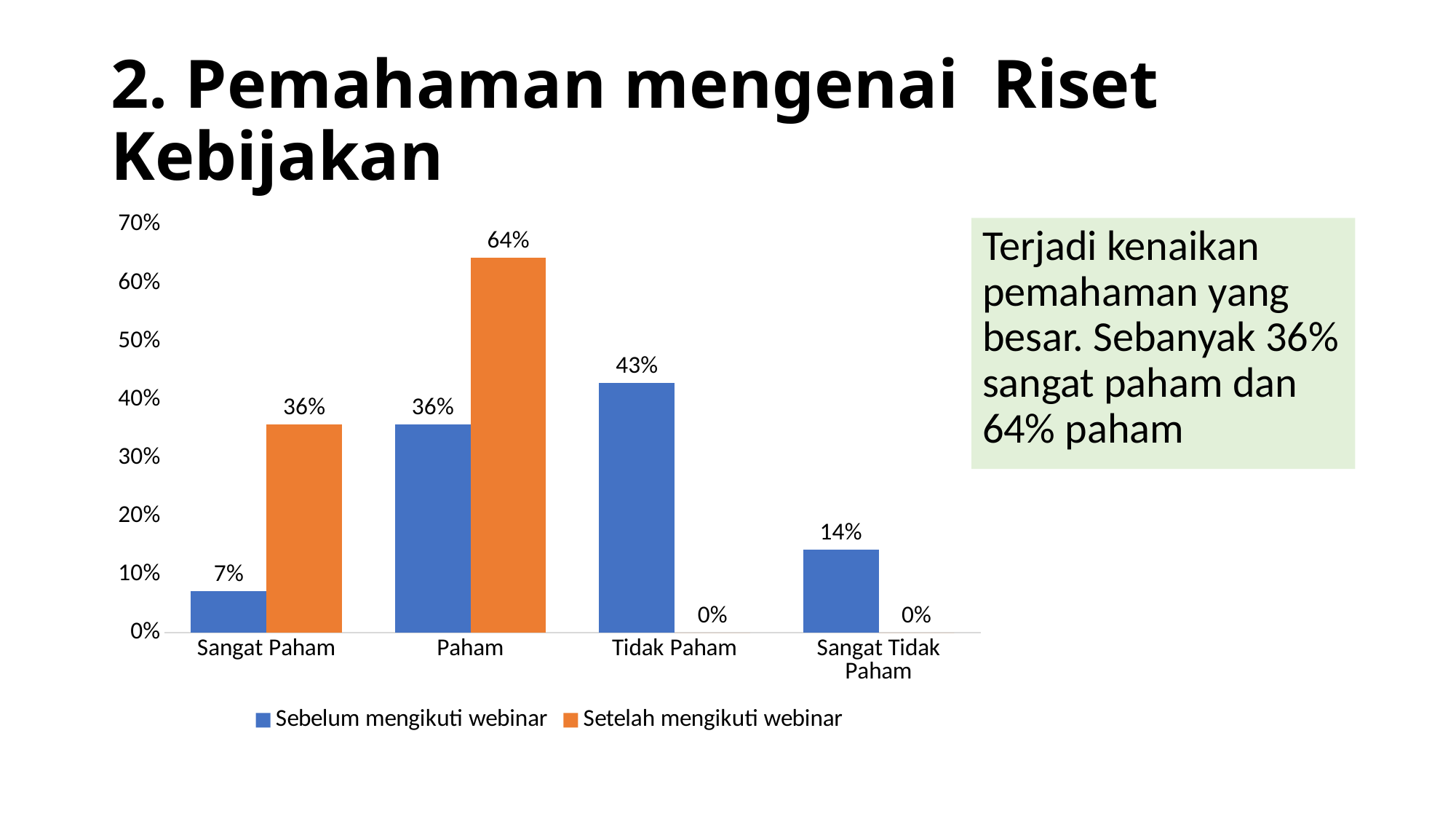
What kind of chart is shown on the slide? Bar chart Which category has the lowest value in the Sebelum mengikuti webinar series? Sangat Paham How many series does the legend list? 2 Which category has the highest value in the Sebelum mengikuti webinar series? Tidak Paham How many categories are shown on the x axis? 4 What is the value for Paham in the Setelah mengikuti webinar series? 64% What is the difference between the Setelah mengikuti webinar and Sebelum mengikuti webinar values for Sangat Paham? 29% Which is larger for Paham: the Sebelum mengikuti webinar value or the Setelah mengikuti webinar value? Setelah mengikuti webinar What is the value for Sangat Tidak Paham in the Setelah mengikuti webinar series? 0% What is the value for Tidak Paham in the Sebelum mengikuti webinar series? 43% Which colour represents the Setelah mengikuti webinar series? Orange What is the value for Sangat Paham in the Sebelum mengikuti webinar series? 7%